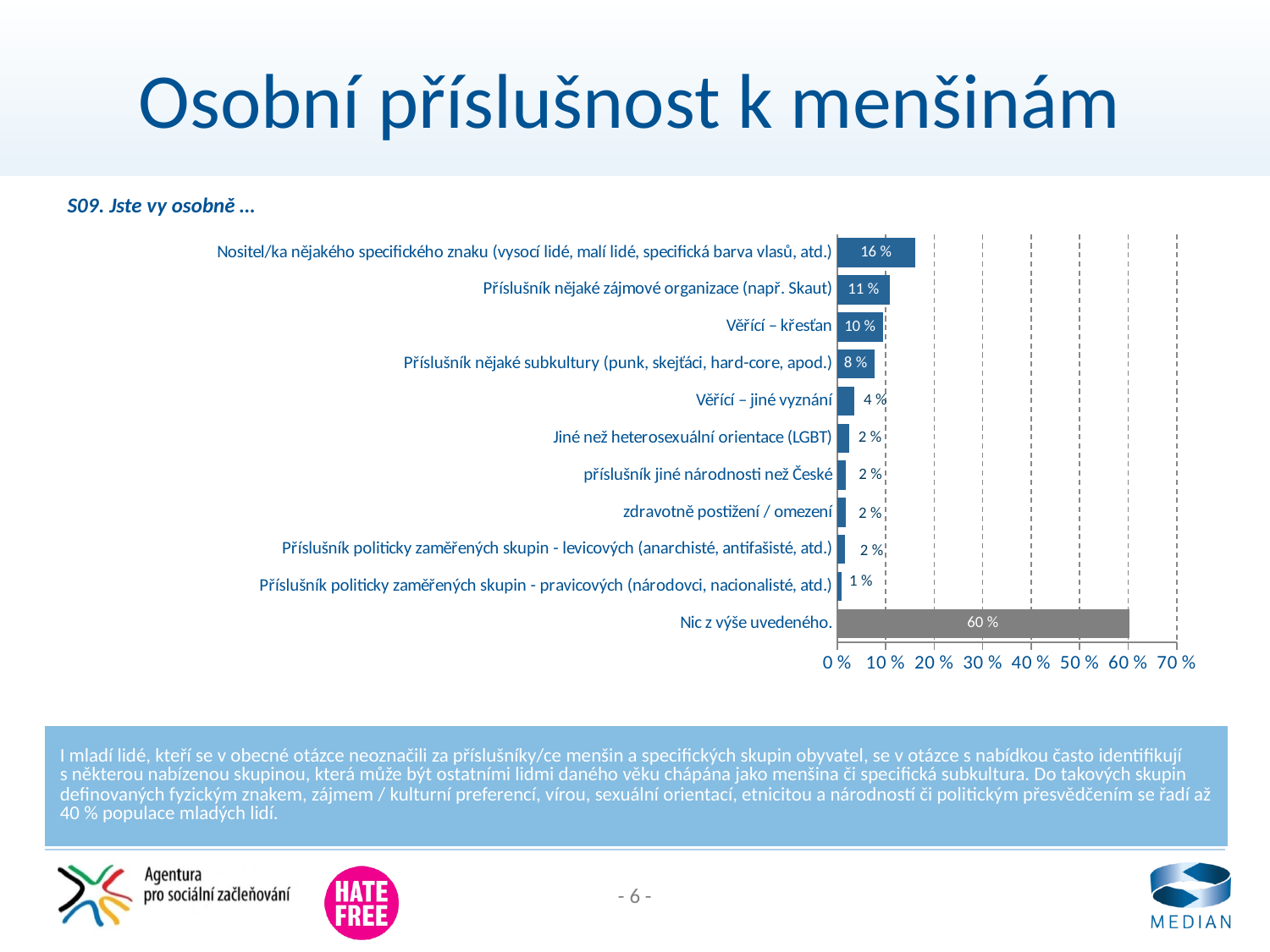
What is the value for "Nositel/ka nějakého specifického znaku (vysocí lidé, malí lidé, specifická barva vlasů, atd.)"? 16 % Which category has the highest value? Nic z výše uvedeného. Which category has the lowest value? Příslušník politicky zaměřených skupin - pravicových (národovci, nacionalisté, atd.) Is the value for "Nic z výše uvedeného." greater or less than 50 %? greater How many categories are shown in the chart? 11 What is the value for "Nic z výše uvedeného."? 60 % What is the difference between the values for "Nositel/ka nějakého specifického znaku" and "Příslušník nějaké zájmové organizace (např. Skaut)"? 5 % What is the value for "Věřící – křesťan"? 10 % What is the question text shown above the chart? S09. Jste vy osobně … Which is larger: the value for "Věřící – křesťan" or the value for "Věřící – jiné vyznání"? Věřící – křesťan What kind of chart is shown on the slide? bar chart What is the value for "Příslušník nějaké subkultury (punk, skejťáci, hard-core, apod.)"? 8 %